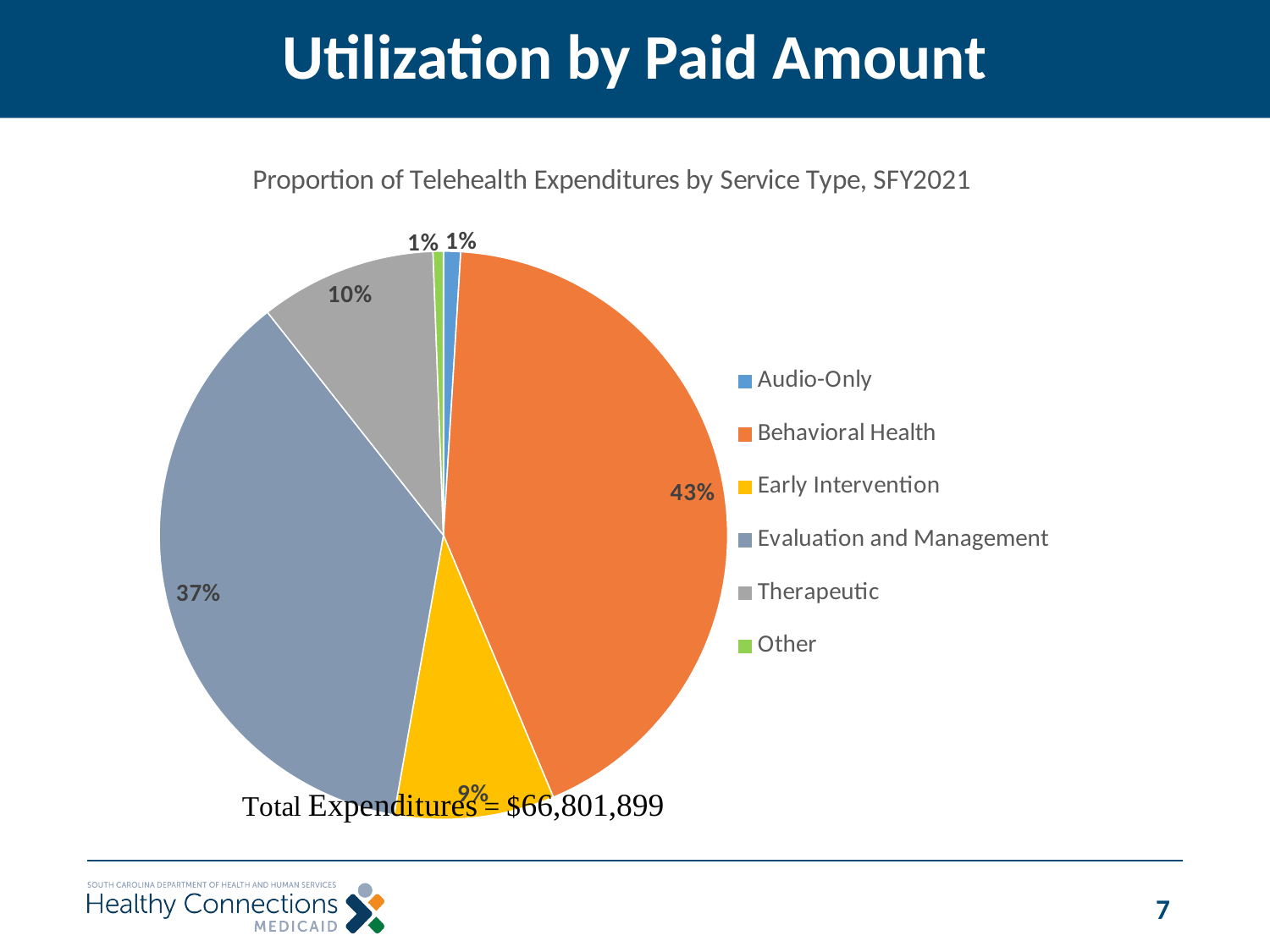
Which has a larger share, Therapeutic or Early Intervention? Therapeutic What total expenditure amount is stated on the slide? $66,801,899 What share of telehealth expenditures is Evaluation and Management? 37% What is the title of the chart? Proportion of Telehealth Expenditures by Service Type, SFY2021 What share of telehealth expenditures is Therapeutic? 10% How many service types are shown in the legend? 6 What share of telehealth expenditures is Early Intervention? 9% What is the difference in percentage points between the Behavioral Health and Evaluation and Management shares? 6 percentage points Which service type has the largest share of telehealth expenditures? Behavioral Health What type of chart is shown on the slide? Pie chart